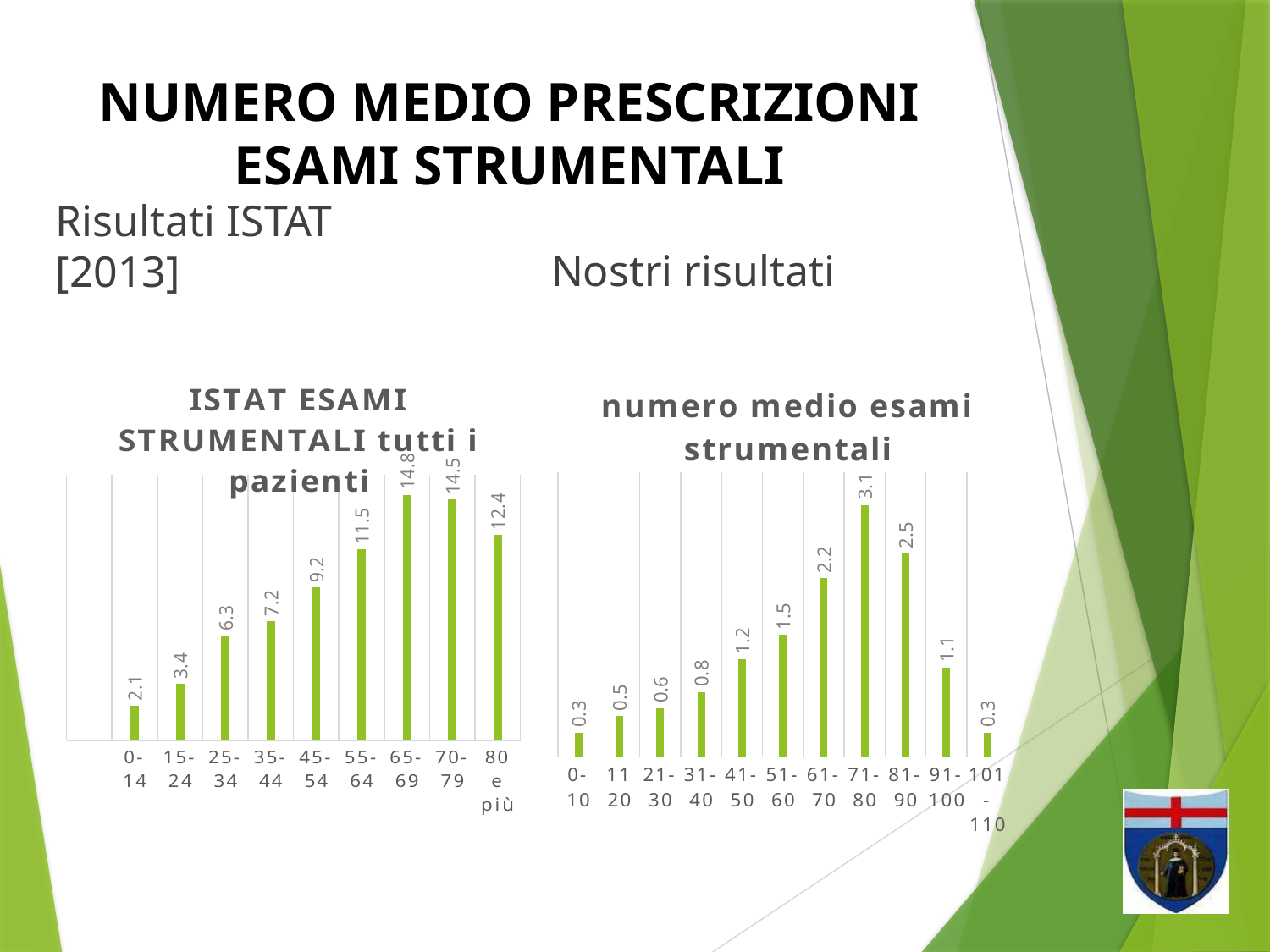
In the left chart (ISTAT ESAMI STRUMENTALI tutti i pazienti), which age group has the highest value? 65-69 In the right chart (numero medio esami strumentali), what is the difference between the values for 71-80 and 91-100? 2.0 In the left chart (ISTAT ESAMI STRUMENTALI tutti i pazienti), what is the value for the 45-54 age group? 9.2 In the left chart (ISTAT ESAMI STRUMENTALI tutti i pazienti), how many age groups are shown? 9 In the right chart (numero medio esami strumentali), what is the value for the 71-80 age group? 3.1 In the left chart (ISTAT ESAMI STRUMENTALI tutti i pazienti), what is the difference between the values for 55-64 and 25-34? 5.2 What type of chart is the right chart (numero medio esami strumentali)? Bar chart In the right chart (numero medio esami strumentali), which age group has the highest value? 71-80 In the left chart (ISTAT ESAMI STRUMENTALI tutti i pazienti), which age group has the lowest value? 0-14 In the right chart (numero medio esami strumentali), which is larger, the value for 61-70 or the value for 81-90? 81-90 In the right chart (numero medio esami strumentali), what is the value for the 41-50 age group? 1.2 In the right chart (numero medio esami strumentali), how many age groups are shown? 11